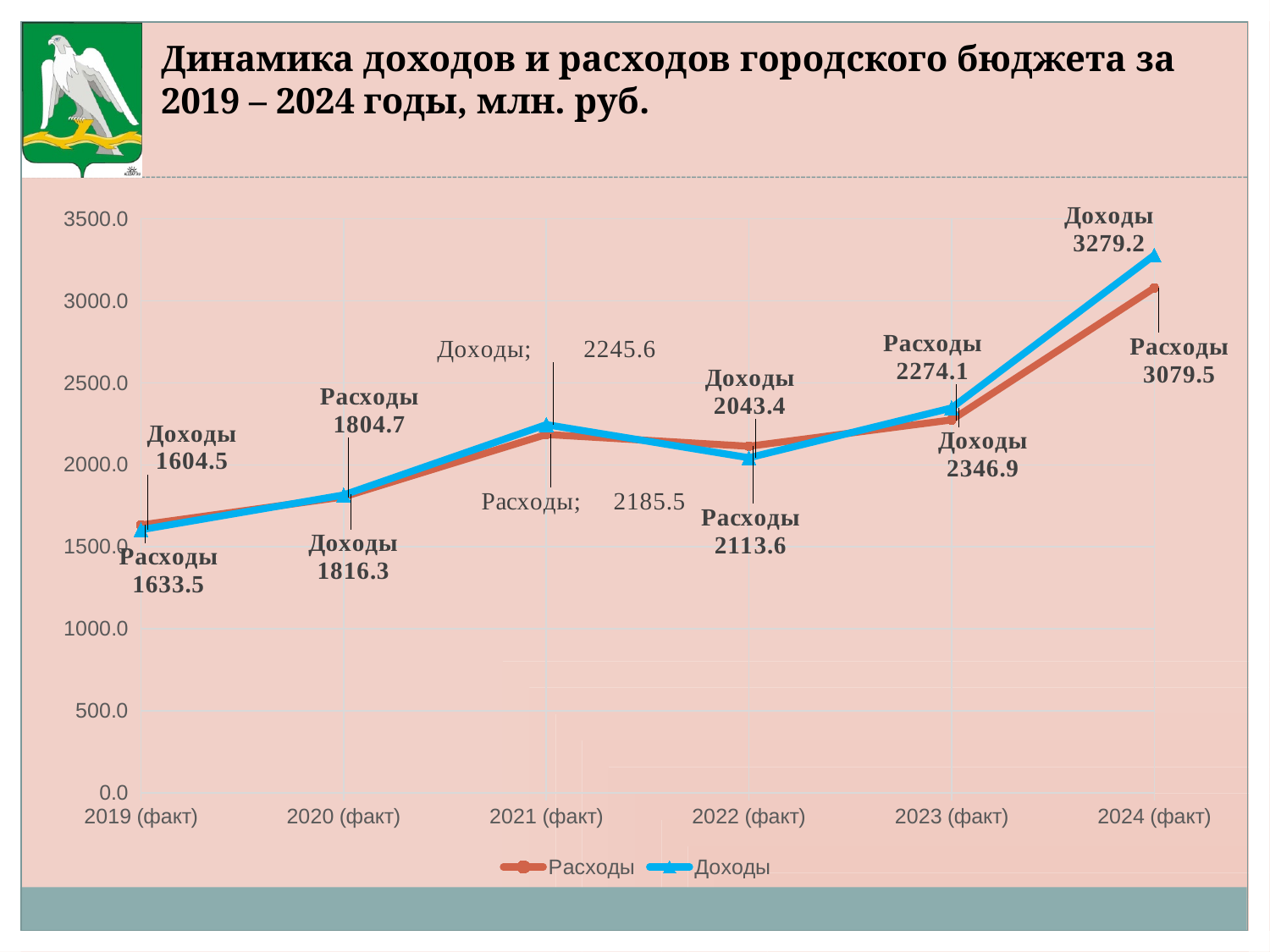
What is the difference between Доходы and Расходы in 2024 (факт)? 199.7 What is the difference between Доходы and Расходы in 2021 (факт)? 60.1 In which year does the Доходы series reach its highest value? 2024 (факт) In 2022 (факт), which is larger: Доходы or Расходы? Расходы What kind of chart is shown on the slide? line chart In which year is the Расходы series at its lowest value? 2019 (факт) How many series does the legend list? 2 Is the value of Доходы for 2024 (факт) greater or less than 3000.0? greater What is the value of Доходы for 2019 (факт)? 1604.5 What is the value of Расходы for 2023 (факт)? 2274.1 How many years are shown on the x axis? 6 What is the value of Доходы for 2021 (факт)? 2245.6